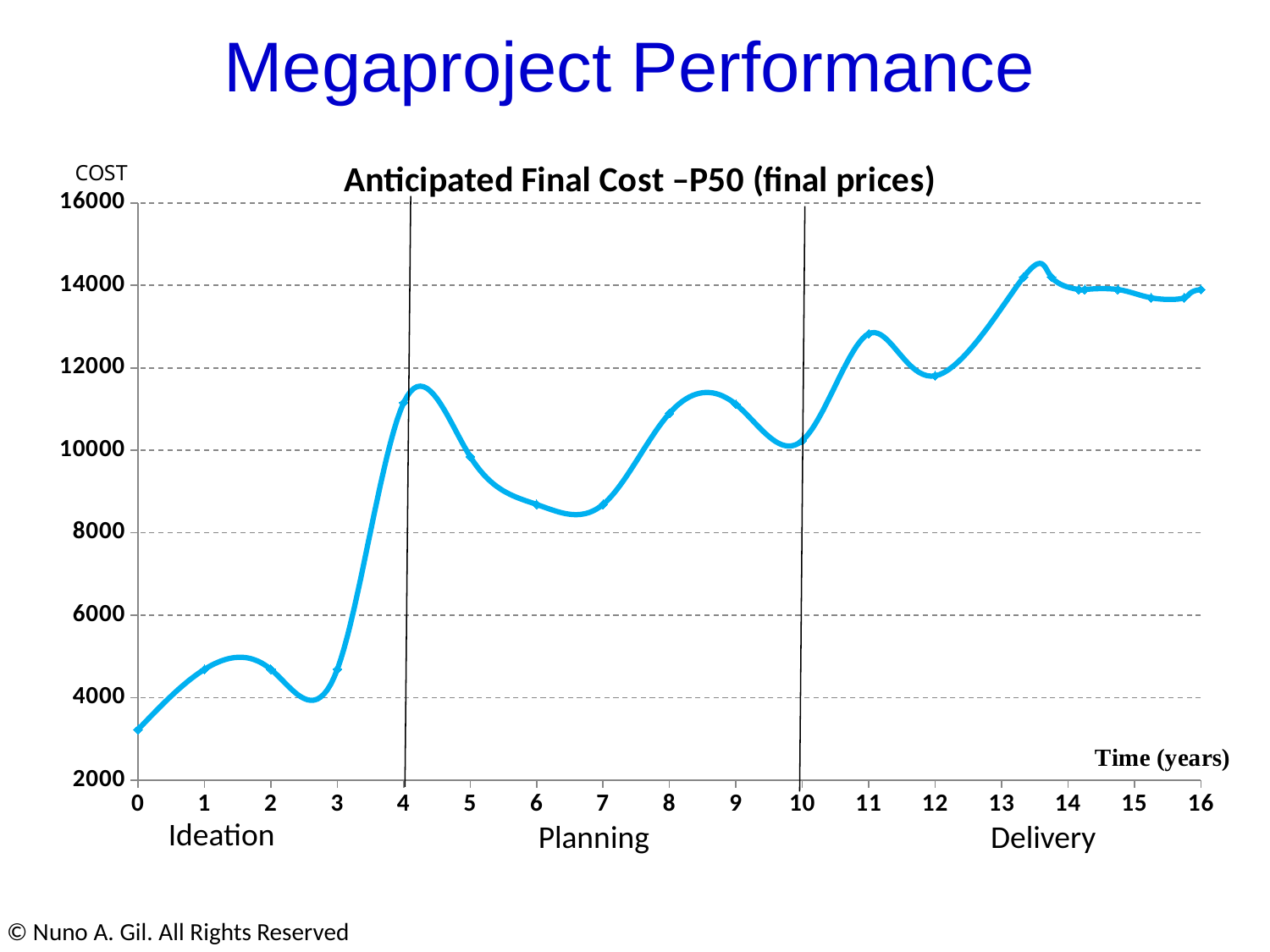
Which is larger, the value at year 11 or the value at year 12? year 11 Overall, does the anticipated final cost rise or fall from year 0 to year 16? rise What kind of chart is shown on the slide? line chart Is the value at year 3 greater or less than 6000? less Which is larger, the value at year 4 or the value at year 6? year 4 What is the title of the chart? Anticipated Final Cost –P50 (final prices) At which year is the anticipated final cost lowest? 0 Is the value at year 0 greater or less than 4000? less Is the value at year 4 greater or less than 10000? greater What are the three project phases labelled along the x axis? Ideation, Planning, Delivery